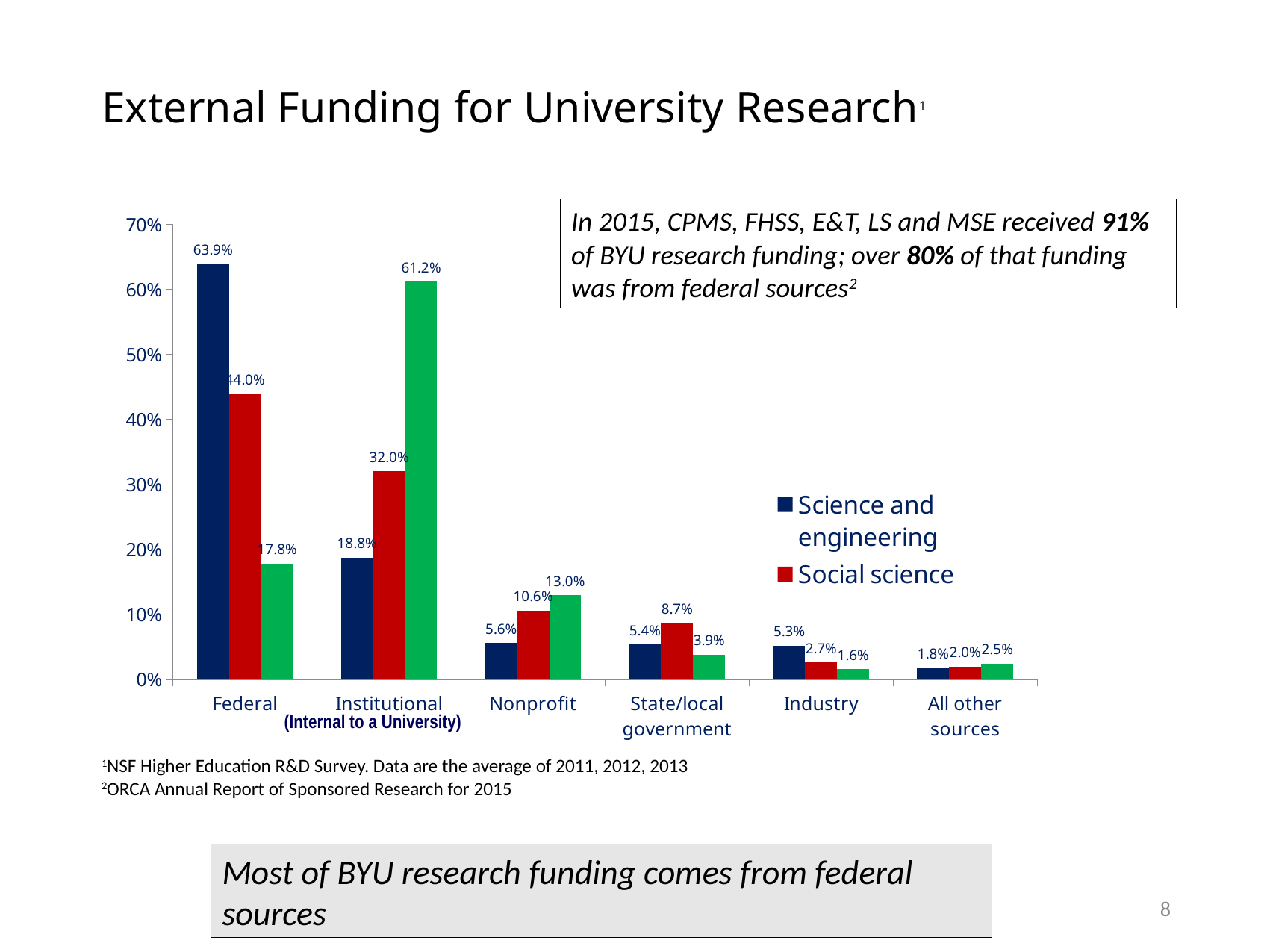
What kind of chart is shown on the slide? Bar chart What is the difference between the Science and engineering and Social science values for Federal funding? 19.9% Is the Social science value for Federal funding greater or less than 40%? greater How many funding source categories are shown on the x axis? 6 What is the Science and engineering value for Industry funding? 5.3% What is the Social science value for Nonprofit funding? 10.6% What colour are the Social science bars? Red What is the Science and engineering value for Federal funding? 63.9% Which category has the highest Science and engineering value? Federal What is the Social science value for Institutional funding? 32.0% Which category has the lowest Social science value? All other sources For State/local government, which is larger: the Science and engineering value or the Social science value? Social science